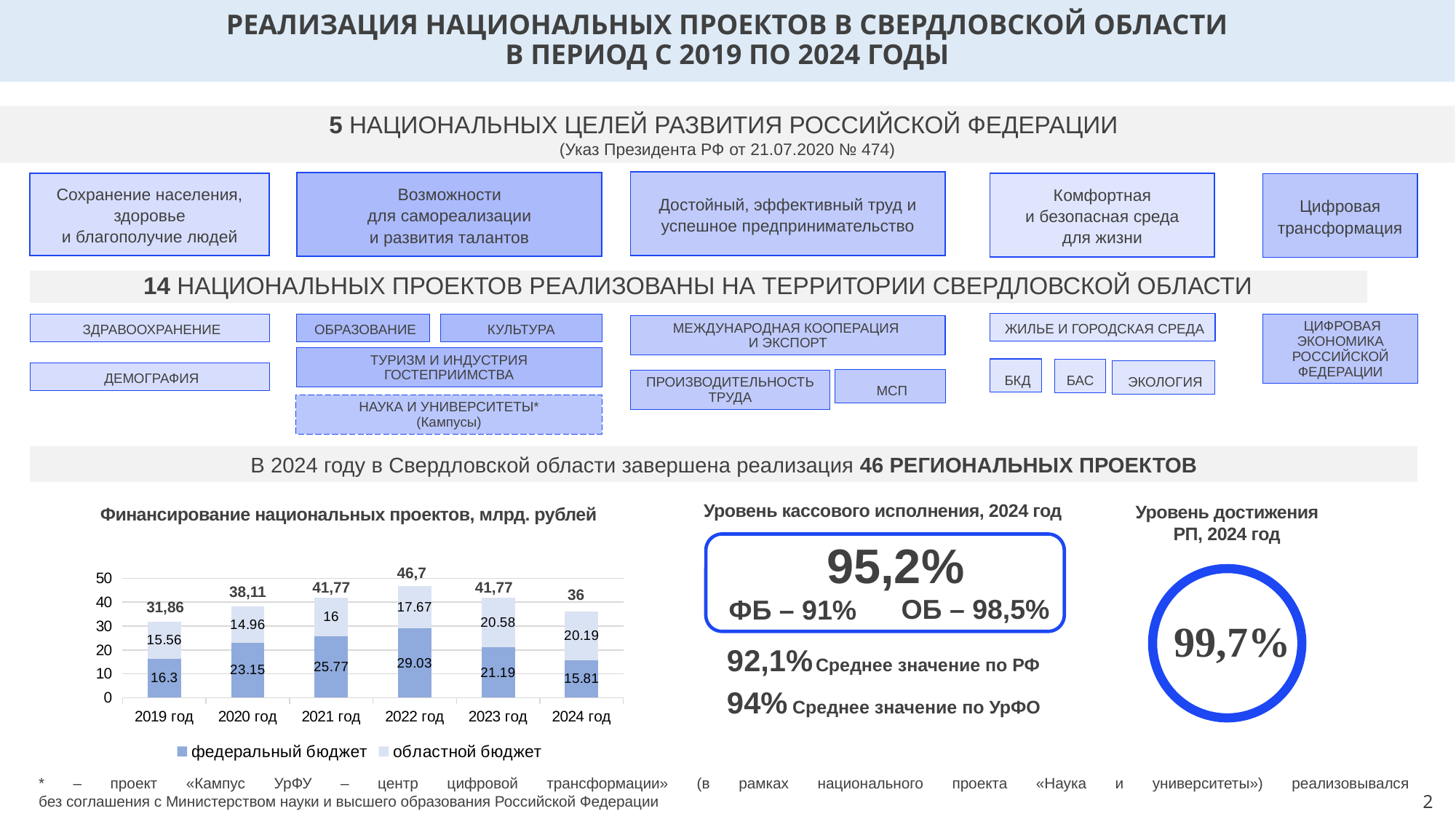
In the chart 'Финансирование национальных проектов, млрд. рублей', does the федеральный бюджет value rise or fall from 2022 год to 2024 год? fall What kind of chart is 'Финансирование национальных проектов, млрд. рублей'? stacked bar chart In the chart 'Финансирование национальных проектов, млрд. рублей', what is the difference between the федеральный бюджет values for 2022 год and 2024 год? 13.22 In the chart 'Финансирование национальных проектов, млрд. рублей', which is larger for 2024 год: федеральный бюджет or областной бюджет? областной бюджет What is the total of the stacked bar for 2019 год in the chart 'Финансирование национальных проектов, млрд. рублей'? 31,86 How many series does the legend of the chart 'Финансирование национальных проектов, млрд. рублей' list? 2 Which year has the highest total in the chart 'Финансирование национальных проектов, млрд. рублей'? 2022 год How many years are shown on the x axis of the chart 'Финансирование национальных проектов, млрд. рублей'? 6 What is the value for федеральный бюджет in 2022 год in the chart 'Финансирование национальных проектов, млрд. рублей'? 29.03 What is the value for областной бюджет in 2024 год in the chart 'Финансирование национальных проектов, млрд. рублей'? 20.19 In the chart 'Финансирование национальных проектов, млрд. рублей', is the total for 2020 год greater or less than 40? less Which year has the lowest total in the chart 'Финансирование национальных проектов, млрд. рублей'? 2019 год